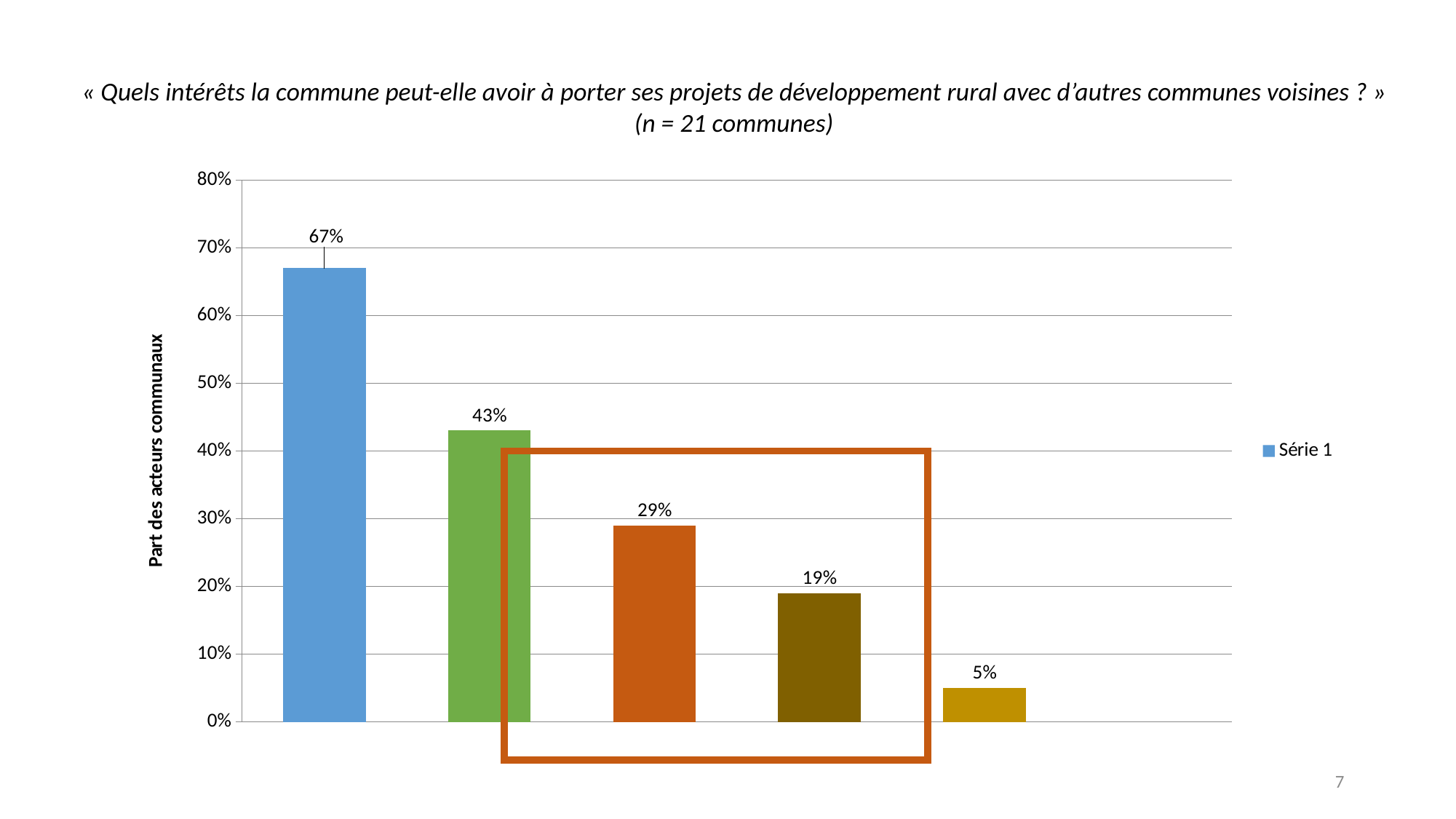
What is the value of the fourth (dark brown) bar from the left? 19% What is the value of the first (blue) bar from the left? 67% What is the value of the last (yellow) bar on the right? 5% How many bars are plotted in the chart? 5 What is the value of the third (orange) bar from the left? 29% Do the bar values rise or fall from left to right? fall What is the highest value shown in the chart? 67% What type of chart is shown on the slide? bar chart How many series does the legend list? 1 What is the value of the second (green) bar from the left? 43% What is the title of the vertical axis? Part des acteurs communaux What is the difference between the first bar (67%) and the second bar (43%)? 24%